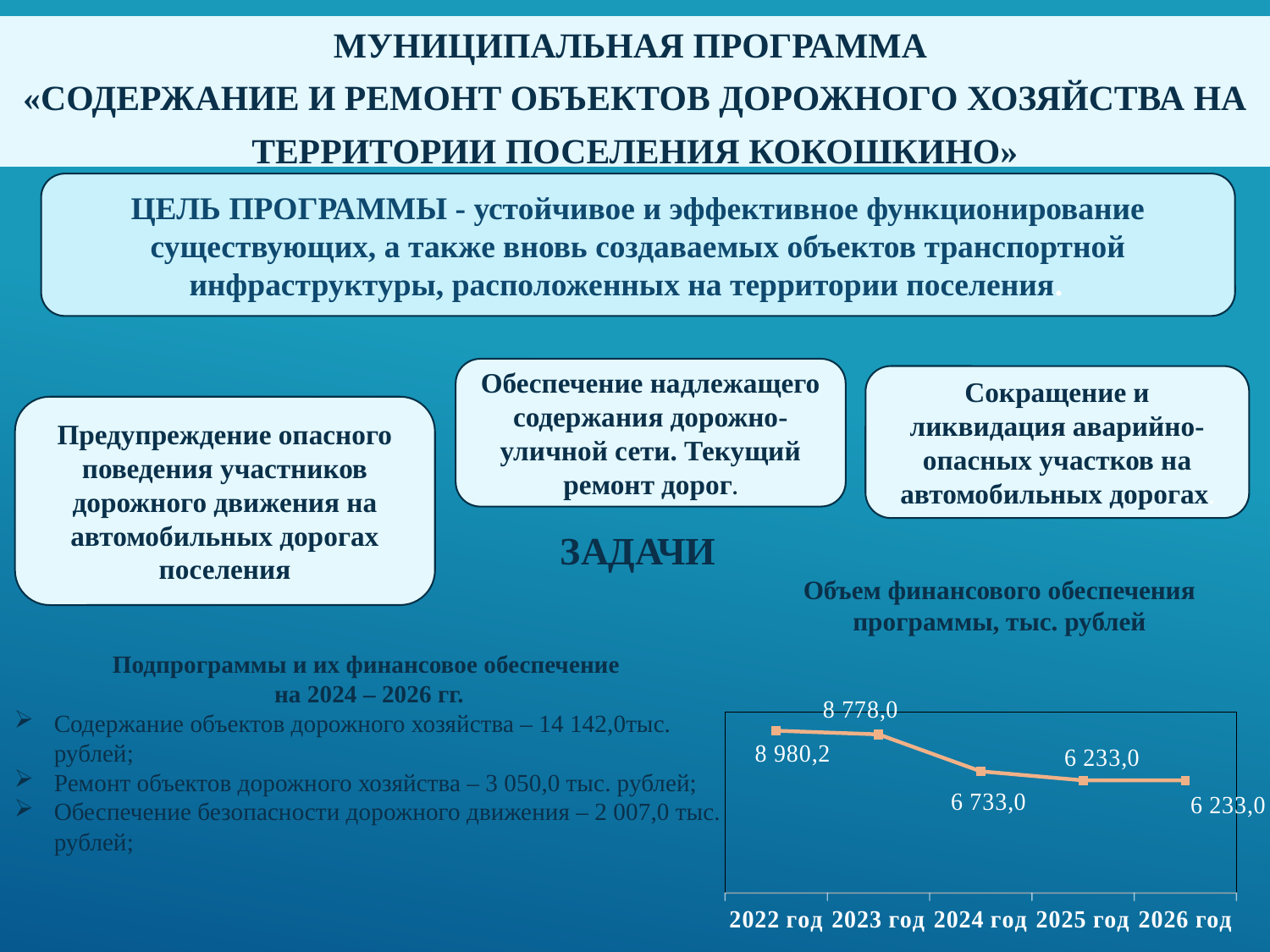
What is the title of the chart on the slide? Объем финансового обеспечения программы, тыс. рублей What is the value for 2023 год? 8 778,0 Which year has the highest value on the chart? 2022 год What is the value for 2022 год? 8 980,2 Which is larger, the value for 2023 год or the value for 2024 год? 2023 год How many data points are plotted on the chart? 5 What is the difference between the values for 2024 год and 2025 год? 500,0 Do the values rise or fall from 2022 год to 2026 год? fall What is the value for 2026 год? 6 233,0 What is the value for 2024 год? 6 733,0 Is the value for 2025 год larger than, smaller than, or equal to the value for 2026 год? equal What type of chart is shown on the slide? line chart